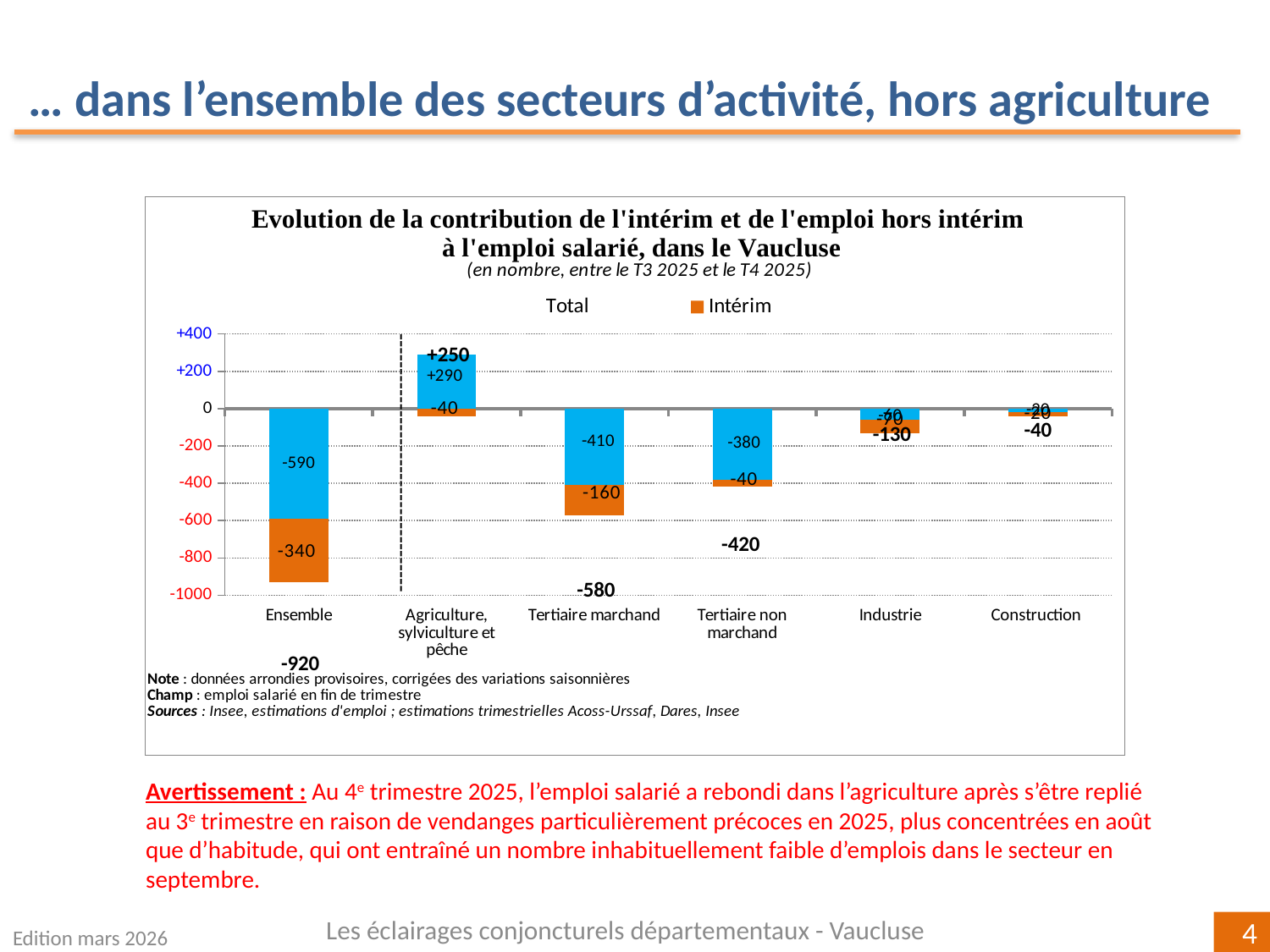
What is the total labelled for Ensemble? -920 What is the value of the blue bar segment for Agriculture, sylviculture et pêche? +290 How many sector categories are shown on the x axis of the chart? 6 What is the difference between the total for Tertiaire marchand and the total for Tertiaire non marchand? 160 Which category has the lowest total value? Ensemble How many series does the chart legend list? 2 What type of chart is shown on the slide? Bar chart What is the Intérim value for Tertiaire marchand? -160 Which category has the highest total value? Agriculture, sylviculture et pêche What is the Intérim value for Ensemble? -340 What is the total labelled for Tertiaire marchand? -580 Which has the lower Intérim value, Tertiaire marchand or Tertiaire non marchand? Tertiaire marchand